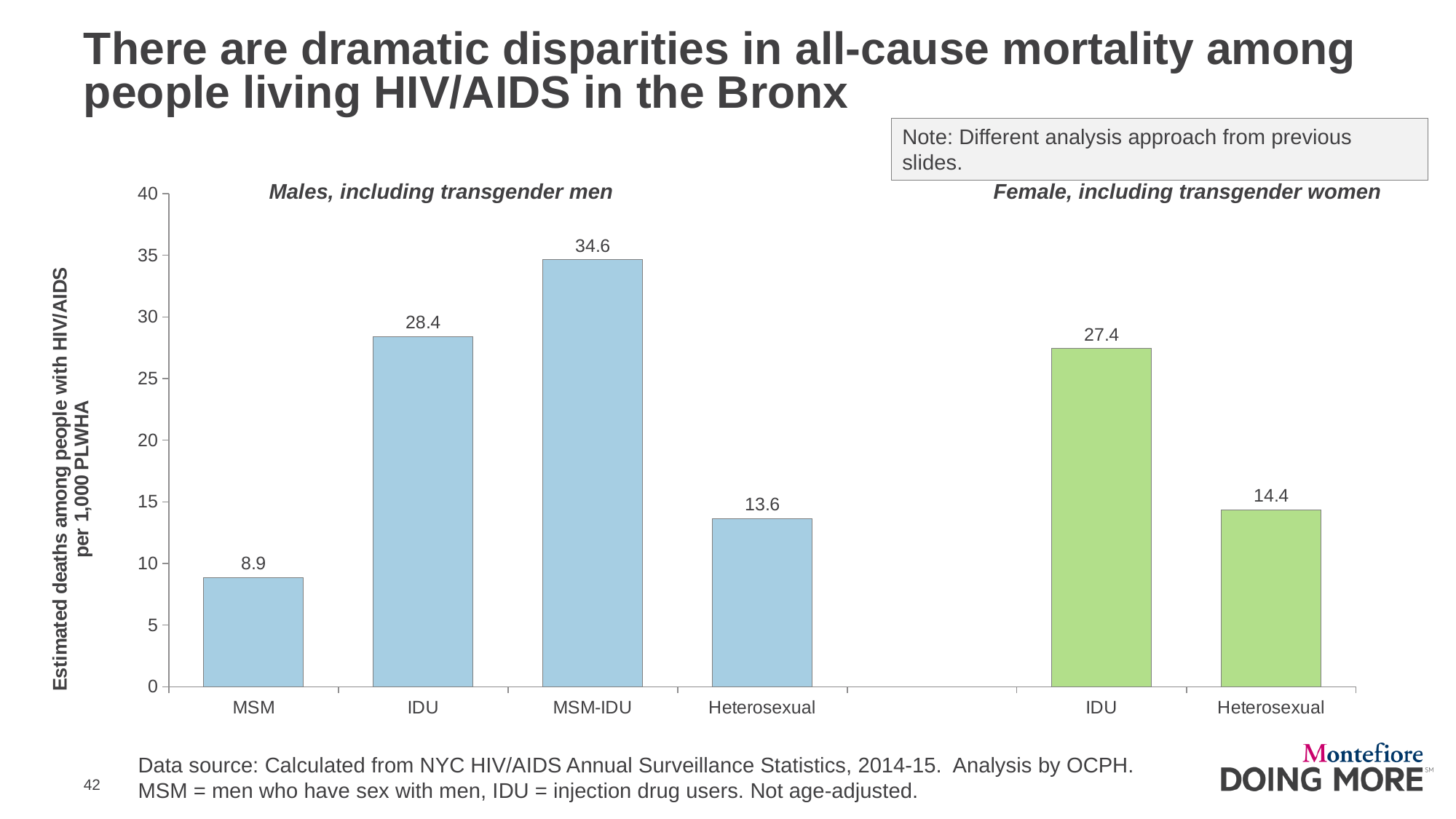
What colour are the bars for the female group? green What is the value for MSM among males? 8.9 How many bars are plotted on the chart? 6 What is the difference between the MSM-IDU value and the MSM value among males? 25.7 Which category has the lowest estimated deaths per 1,000 PLWHA on the chart? MSM What is the estimated deaths per 1,000 PLWHA for MSM-IDU among males? 34.6 Is the value for male Heterosexual greater or less than 15? less Which is larger: the Heterosexual value for males or the Heterosexual value for females? Heterosexual for females What is the value for IDU among females, including transgender women? 27.4 Which category has the highest estimated deaths per 1,000 PLWHA on the chart? MSM-IDU What is the difference between the male IDU value and the female IDU value? 1.0 What kind of chart is shown on the slide? bar chart